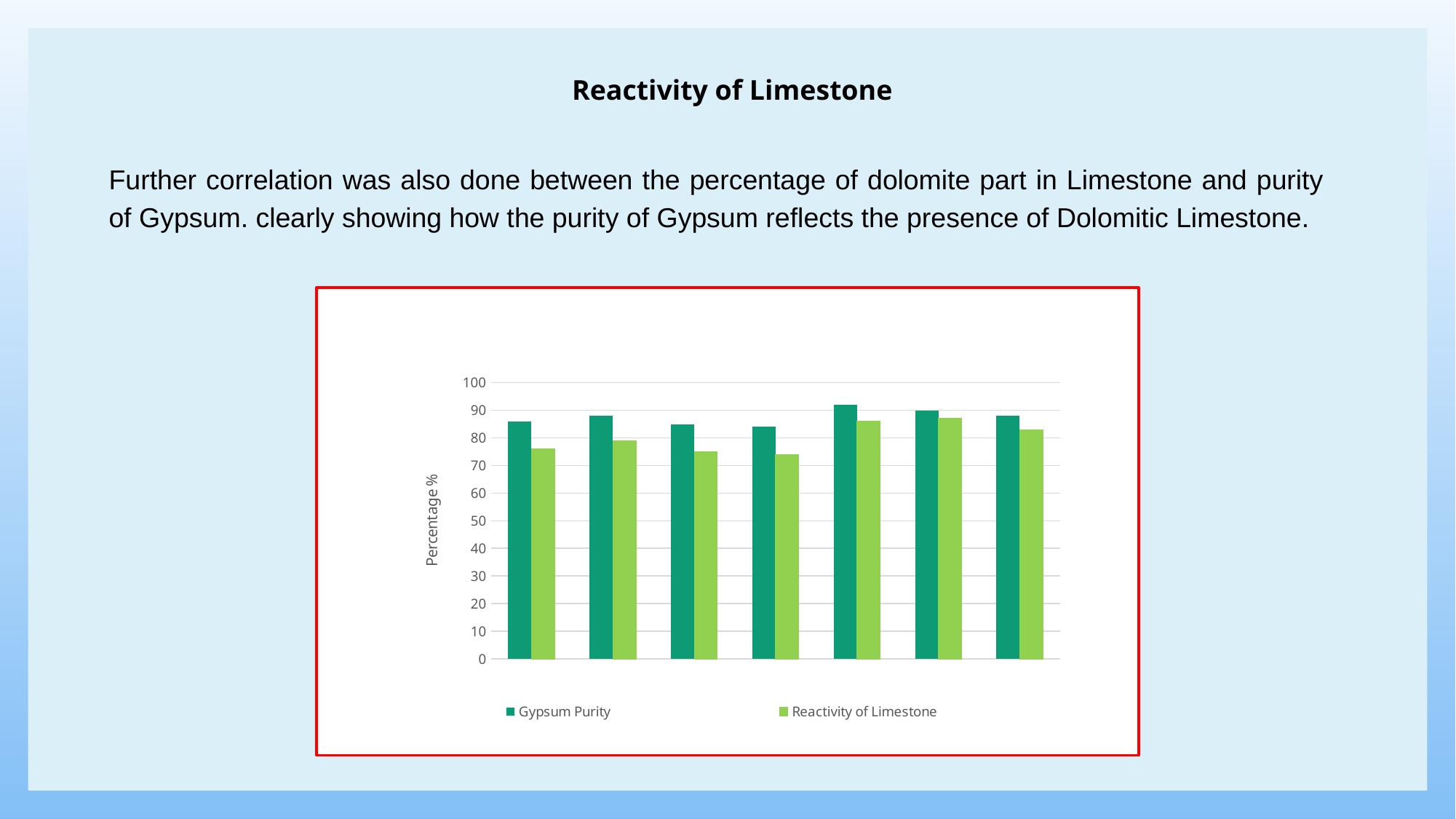
How many series does the chart legend list? 2 In the fourth group of bars from the left, which series has the larger value, Gypsum Purity or Reactivity of Limestone? Gypsum Purity In the second group of bars from the left, is the Gypsum Purity value greater or less than 80? greater In the first group of bars from the left, which series has the larger value, Gypsum Purity or Reactivity of Limestone? Gypsum Purity What are the two series named in the chart legend? Gypsum Purity and Reactivity of Limestone What kind of chart is shown on the slide? bar chart In the first group of bars from the left, is the Reactivity of Limestone value greater or less than 80? less In the seventh group of bars from the left, is the Reactivity of Limestone value greater or less than 80? greater How many groups of bars are plotted in the chart? 7 What is the label on the vertical axis of the chart? Percentage %